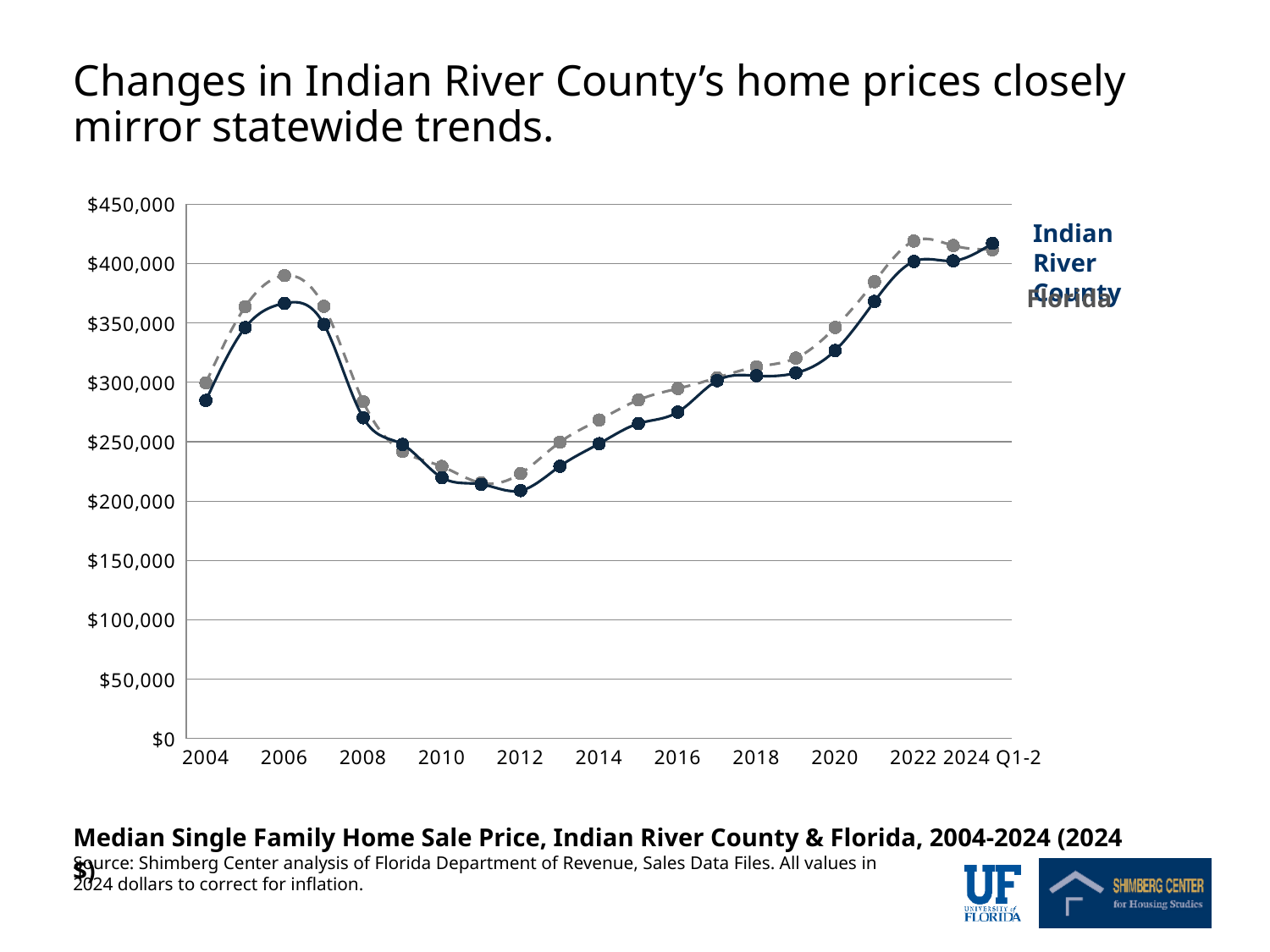
Is the Indian River County value for 2004 greater or less than $300,000? less Which series is drawn with the gray dashed line? Florida Is the Indian River County value for 2012 greater or less than $250,000? less Is the Florida value for 2022 greater or less than $400,000? greater Between 2012 and 2022, does the Indian River County line rise or fall? Rise In 2006, which series has the higher value, Indian River County or Florida? Florida Which two series are plotted on the chart? Indian River County and Florida In which year does the Indian River County line reach its highest value before 2008? 2006 In which year does the Indian River County line reach its lowest value? 2012 What kind of chart is shown on the slide? Line chart How many series does the chart plot? 2